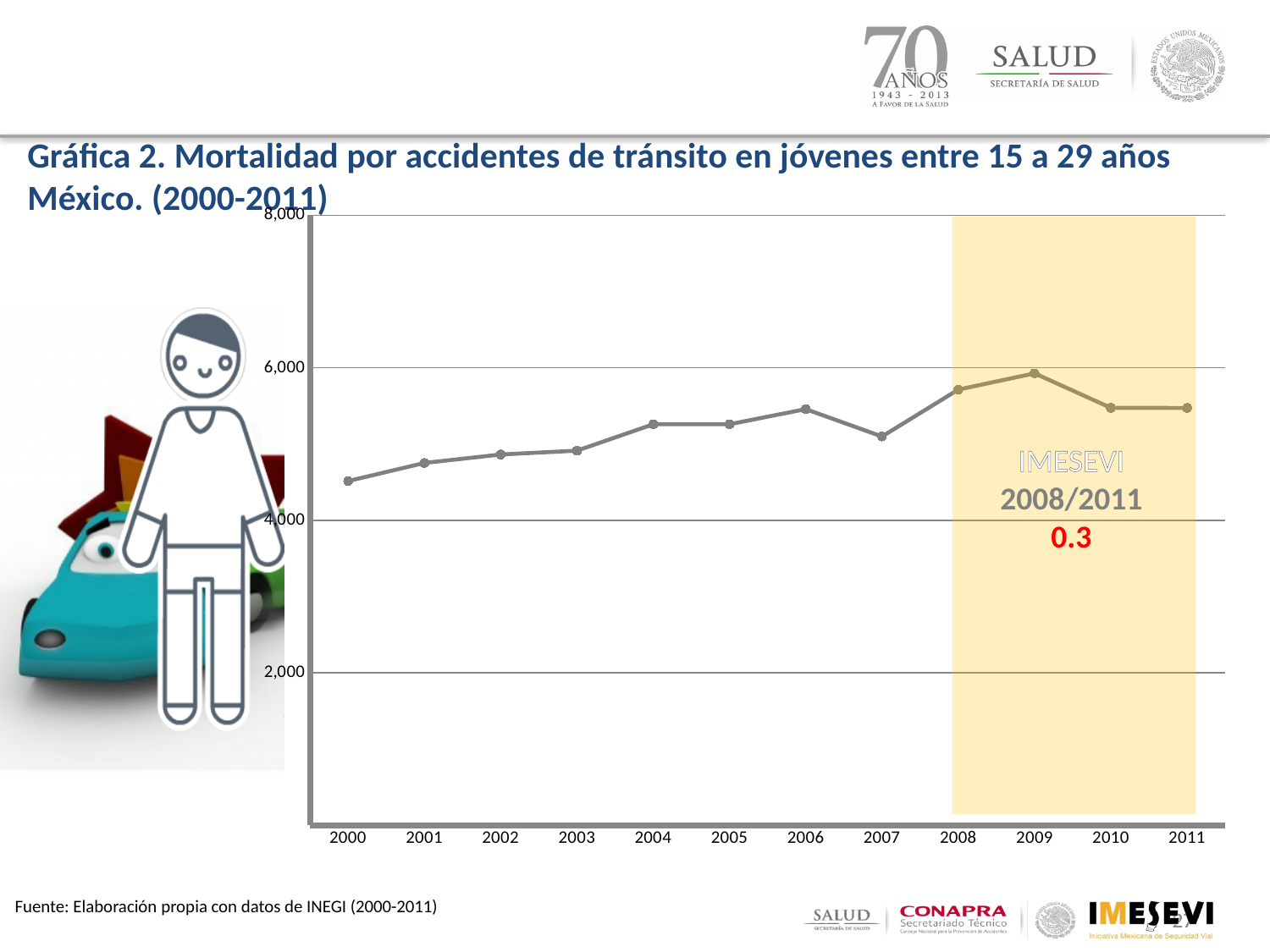
What kind of chart is shown on the slide? line chart Is the value for 2008 greater or less than 6,000? less Is the value for 2011 greater or less than 4,000? greater How many years are plotted along the x axis of the chart? 12 What label appears inside the shaded region covering 2008 to 2011 on the chart? IMESEVI 2008/2011 Which is larger, the value for 2009 or the value for 2000? 2009 Does the line generally rise or fall from 2000 to 2009? rise Which year has the highest value on the chart? 2009 Which is larger, the value for 2006 or the value for 2007? 2006 Which year has the lowest value on the chart? 2000 Is the value for 2007 greater or less than 6,000? less